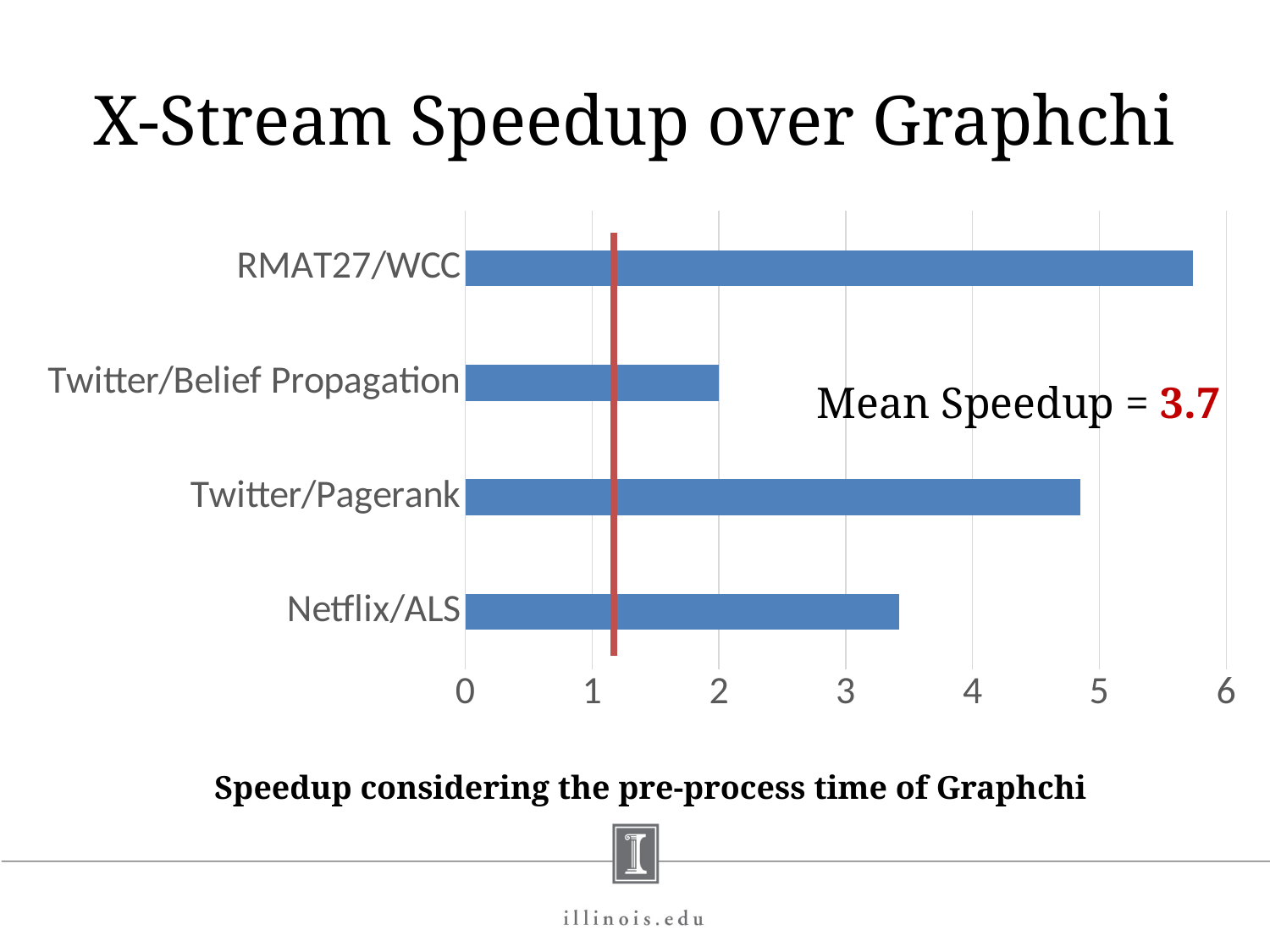
What is the title of the chart on the slide? X-Stream Speedup over Graphchi What mean speedup value is stated on the slide? 3.7 Which has a larger speedup, Twitter/Pagerank or Netflix/ALS? Twitter/Pagerank Which category has the lowest speedup? Twitter/Belief Propagation What kind of chart is shown on the slide? bar chart Is the speedup for Netflix/ALS greater or less than 3? greater How many categories are plotted in the chart? 4 Which category has the highest speedup? RMAT27/WCC Is the speedup for RMAT27/WCC greater or less than 5? greater Which has a larger speedup, RMAT27/WCC or Twitter/Belief Propagation? RMAT27/WCC Is the speedup for Twitter/Belief Propagation greater or less than 3? less